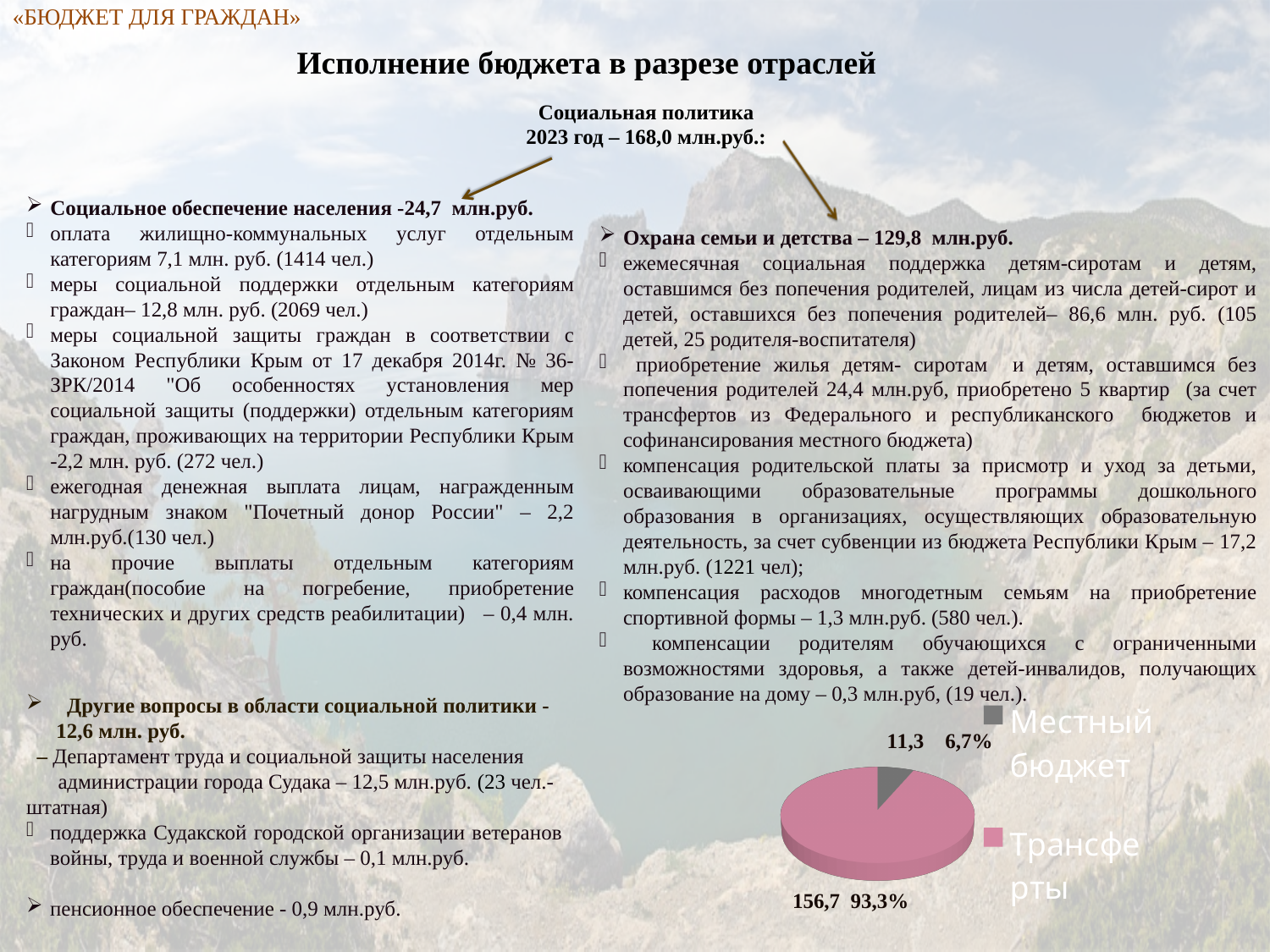
What is the difference between the Трансферты value and the Местный бюджет value in the pie chart? 145,4 What share of the pie does the Трансферты slice represent? 93,3% What value is shown for the Трансферты slice of the pie chart? 156,7 How many slices does the pie chart have? 2 Which slice of the pie chart is the smallest? Местный бюджет What value is shown for the Местный бюджет slice of the pie chart? 11,3 What kind of chart is shown at the bottom right of the slide? pie chart Which slice of the pie chart is the largest? Трансферты What share of the pie does the Местный бюджет slice represent? 6,7% How many entries does the pie chart's legend list? 2 What are the two legend entries of the pie chart? Местный бюджет, Трансферты Which is larger in the pie chart, Трансферты or Местный бюджет? Трансферты